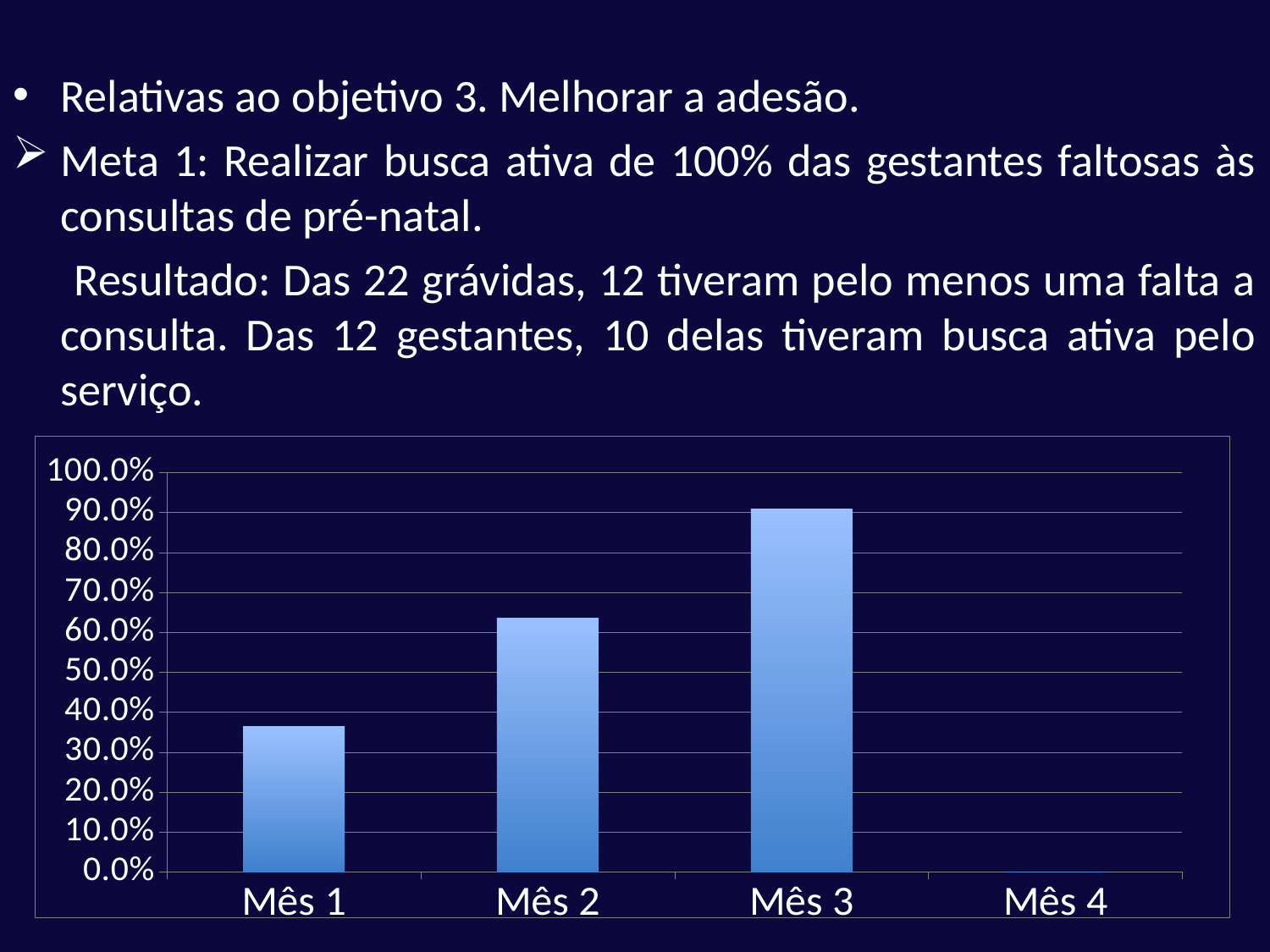
Which is larger, the value for Mês 1 or the value for Mês 2? Mês 2 Is the value for Mês 1 greater or less than 30.0%? greater Is the value for Mês 1 greater or less than 40.0%? less Is the value for Mês 3 greater or less than 80.0%? greater Which month has the highest value in the chart? Mês 3 What kind of chart is shown on the slide? bar chart Which is larger, the value for Mês 2 or the value for Mês 3? Mês 3 Do the values rise or fall from Mês 1 to Mês 3? rise Which month has the lowest value in the chart? Mês 4 How many categories are shown on the x axis of the chart? 4